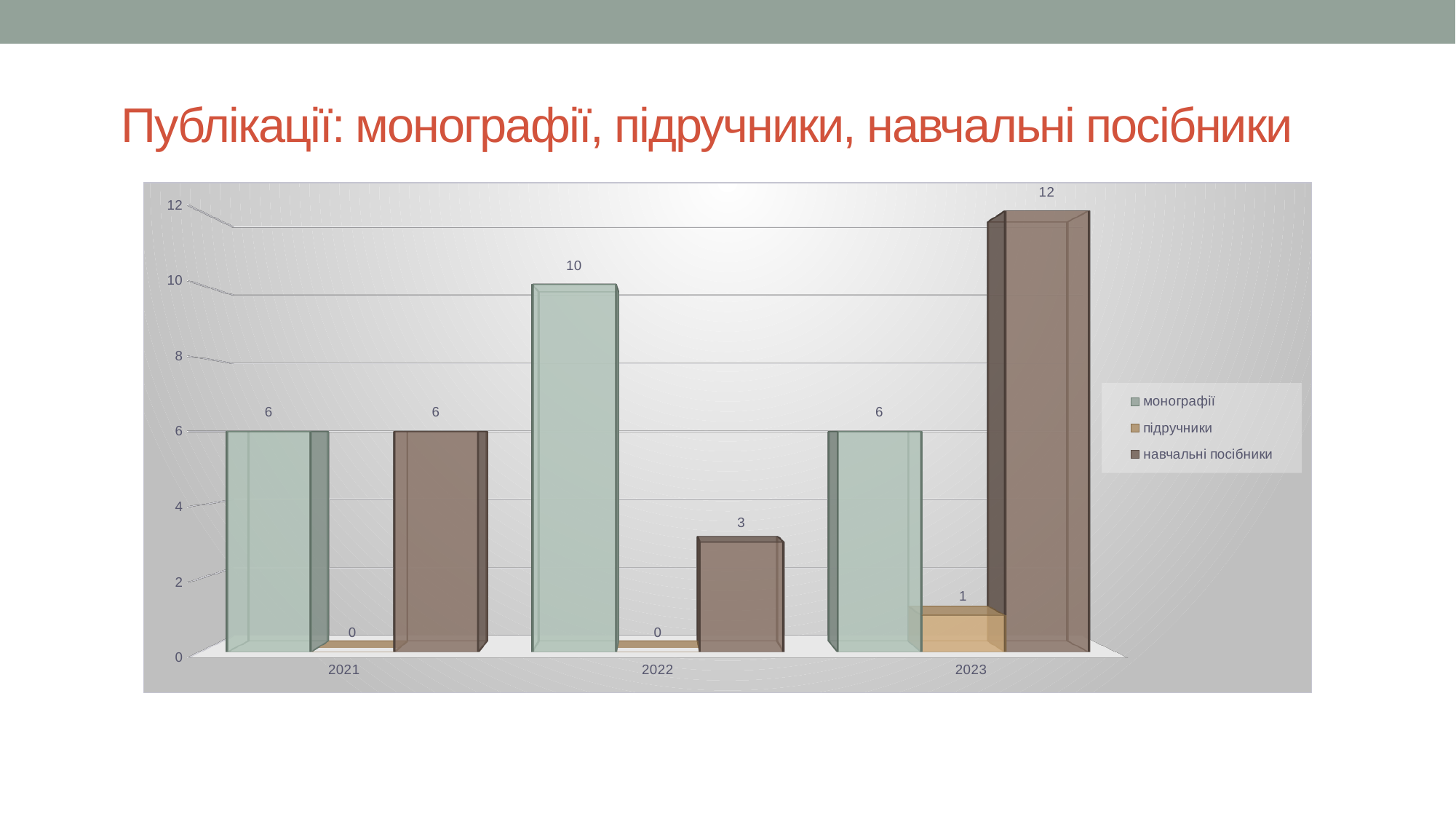
In which year is the value for навчальні посібники highest? 2023 How many series does the legend list? 3 Which is larger in 2022: монографії or навчальні посібники? монографії What is the value for навчальні посібники in 2023? 12 What is the difference between навчальні посібники and монографії in 2023? 6 What is the value for навчальні посібники in 2022? 3 What kind of chart is shown on the slide? bar chart What is the title of the slide? Публікації: монографії, підручники, навчальні посібники What is the value for підручники in 2023? 1 In which year is the value for навчальні посібники lowest? 2022 How many years are shown on the x axis? 3 What is the value for монографії in 2022? 10